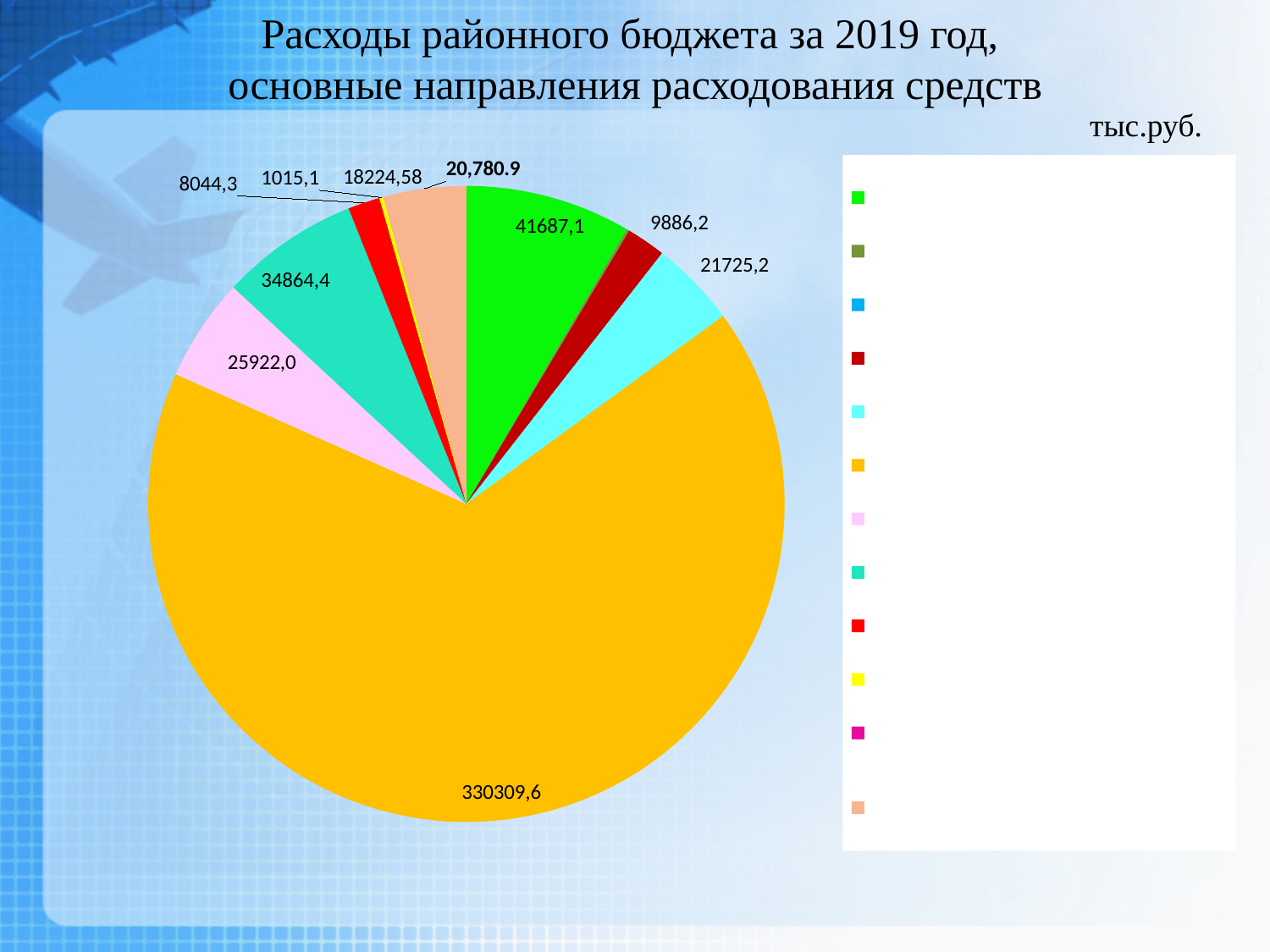
What value is labelled on the teal (blue-green) slice of the pie chart? 34864,4 What value is labelled on the light pink slice of the pie chart? 25922,0 What value is labelled on the light cyan slice of the pie chart? 21725,2 What kind of chart is shown on the slide? pie chart What is the value of the largest slice of the pie chart? 330309,6 Which slice is larger, the teal slice labelled 34864,4 or the pink slice labelled 25922,0? the teal slice (34864,4) How many colour entries does the legend list? 12 What value is labelled on the bright green slice of the pie chart? 41687,1 What is the difference between the green slice (41687,1) and the teal slice (34864,4)? 6822,7 What is the title of the slide? Расходы районного бюджета за 2019 год, основные направления расходования средств What unit of measurement is stated on the slide for the chart values? тыс.руб. What is the smallest value labelled on the pie chart? 1015,1